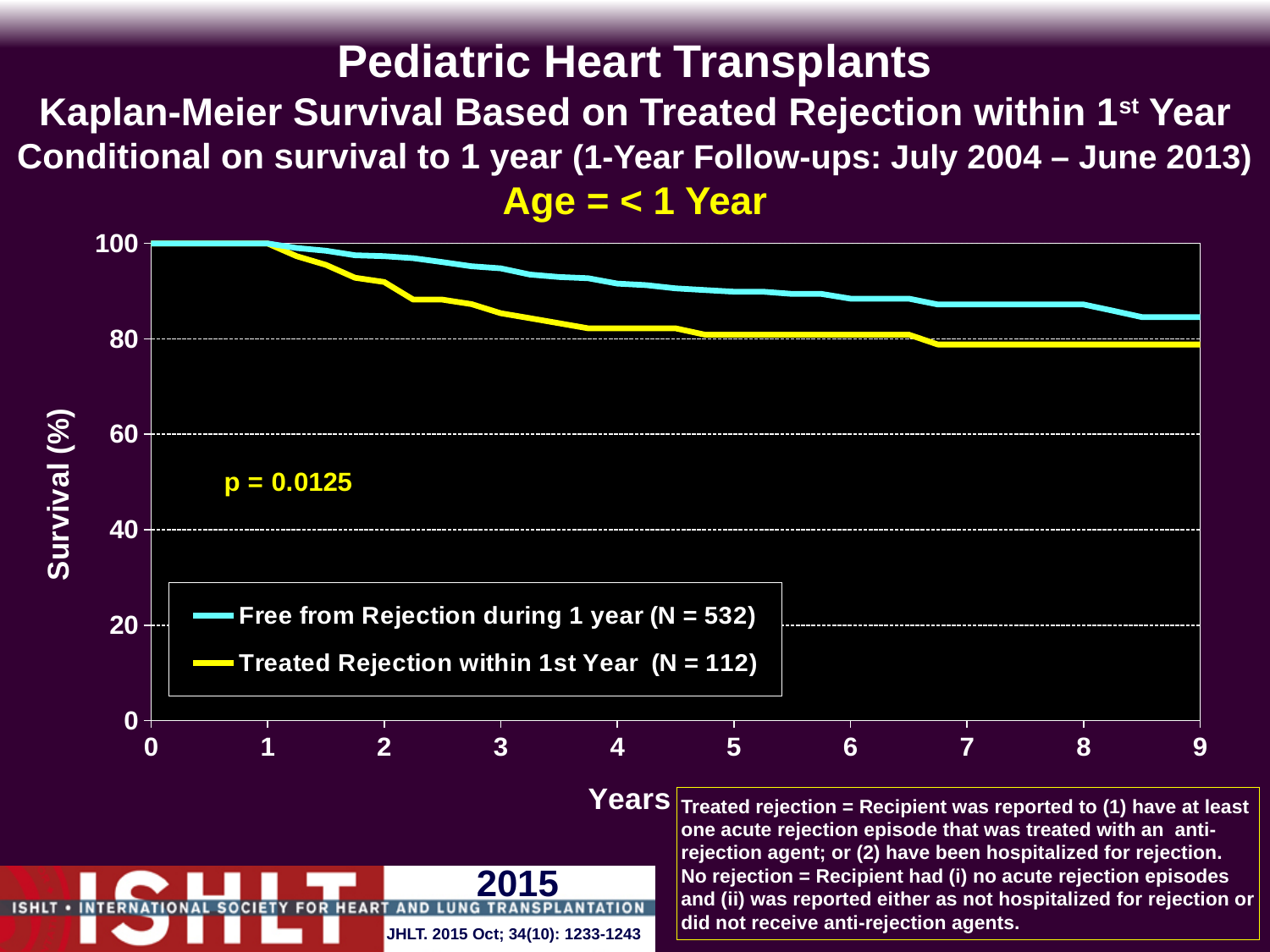
Is the survival value for Treated Rejection within 1st Year at year 9 greater or less than 60? greater What is the survival value for both series at year 0? 100 What is the N for the Treated Rejection within 1st Year series in the legend? 112 What is the label of the y-axis? Survival (%) How many series does the legend list? 2 What kind of chart is shown on the slide? Line chart Do the survival curves rise or fall as years increase? Fall Which series has the higher survival at year 9, Free from Rejection during 1 year or Treated Rejection within 1st Year? Free from Rejection during 1 year Is the survival value for Free from Rejection during 1 year at year 9 greater or less than 80? greater What is the p-value shown on the chart? p = 0.0125 Is the survival value for Treated Rejection within 1st Year at year 3 greater or less than 80? greater Which series has the lower survival at year 5? Treated Rejection within 1st Year